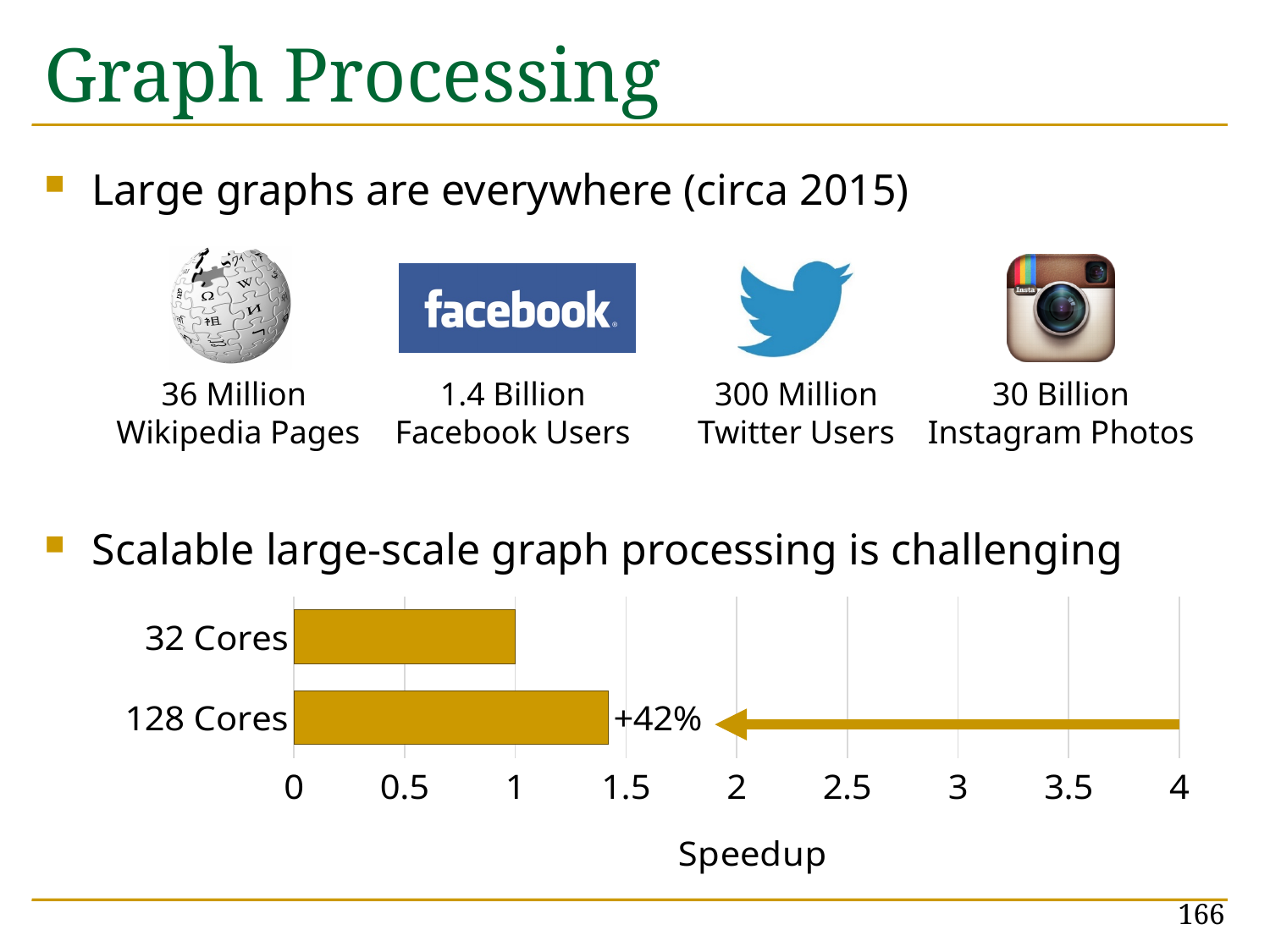
Which category has the higher speedup in the bar chart? 128 Cores Is the speedup for 128 Cores greater or less than 2? less Is the speedup for 128 Cores greater or less than 1? greater What is the maximum value shown on the x axis of the bar chart? 4 What is the speedup value for 32 Cores in the bar chart? 1 What is the label of the x axis of the bar chart? Speedup How many categories does the bar chart show? 2 What kind of chart is shown at the bottom of the slide? bar chart Is the speedup for 32 Cores or for 128 Cores larger? 128 Cores Which category has the lower speedup in the bar chart? 32 Cores Is the speedup for 128 Cores greater or less than 1.5? less What percentage annotation is printed next to the 128 Cores bar? +42%